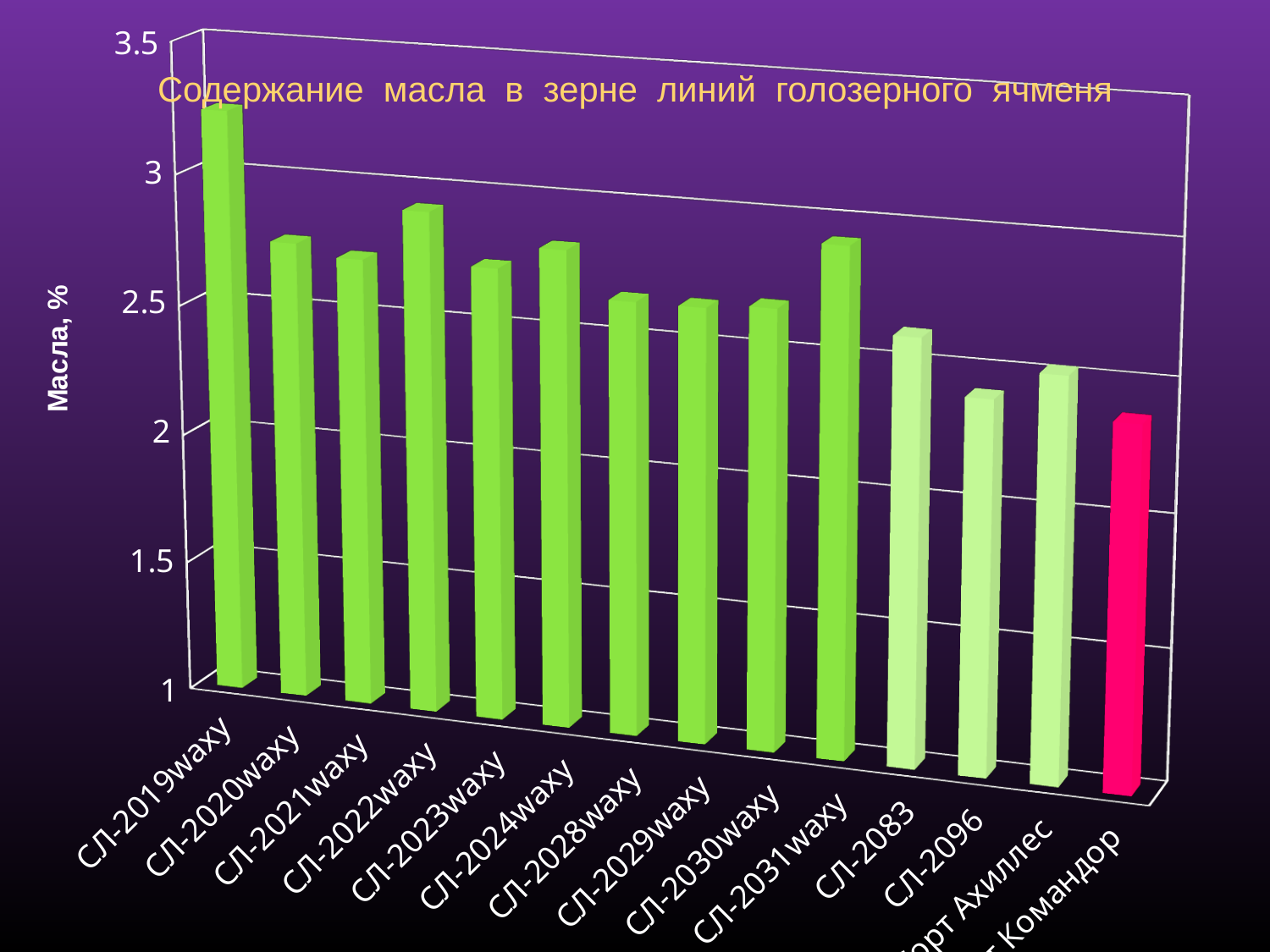
How many bars are plotted in the chart? 14 Which category has the highest oil content? СЛ-2019waxy Which is larger, the value for СЛ-2019waxy or for СЛ-2022waxy? СЛ-2019waxy What is the title of the chart? Содержание масла в зерне линий голозерного ячменя Is the value for СЛ-2019waxy greater or less than 3? greater What is the label of the vertical axis? Масла, % Which is larger, the value for СЛ-2022waxy or for СЛ-2083? СЛ-2022waxy Is the value for СЛ-2020waxy greater or less than 2.5? greater Is the value for СЛ-2022waxy greater or less than 2.5? greater What kind of chart is shown on the slide? Bar chart